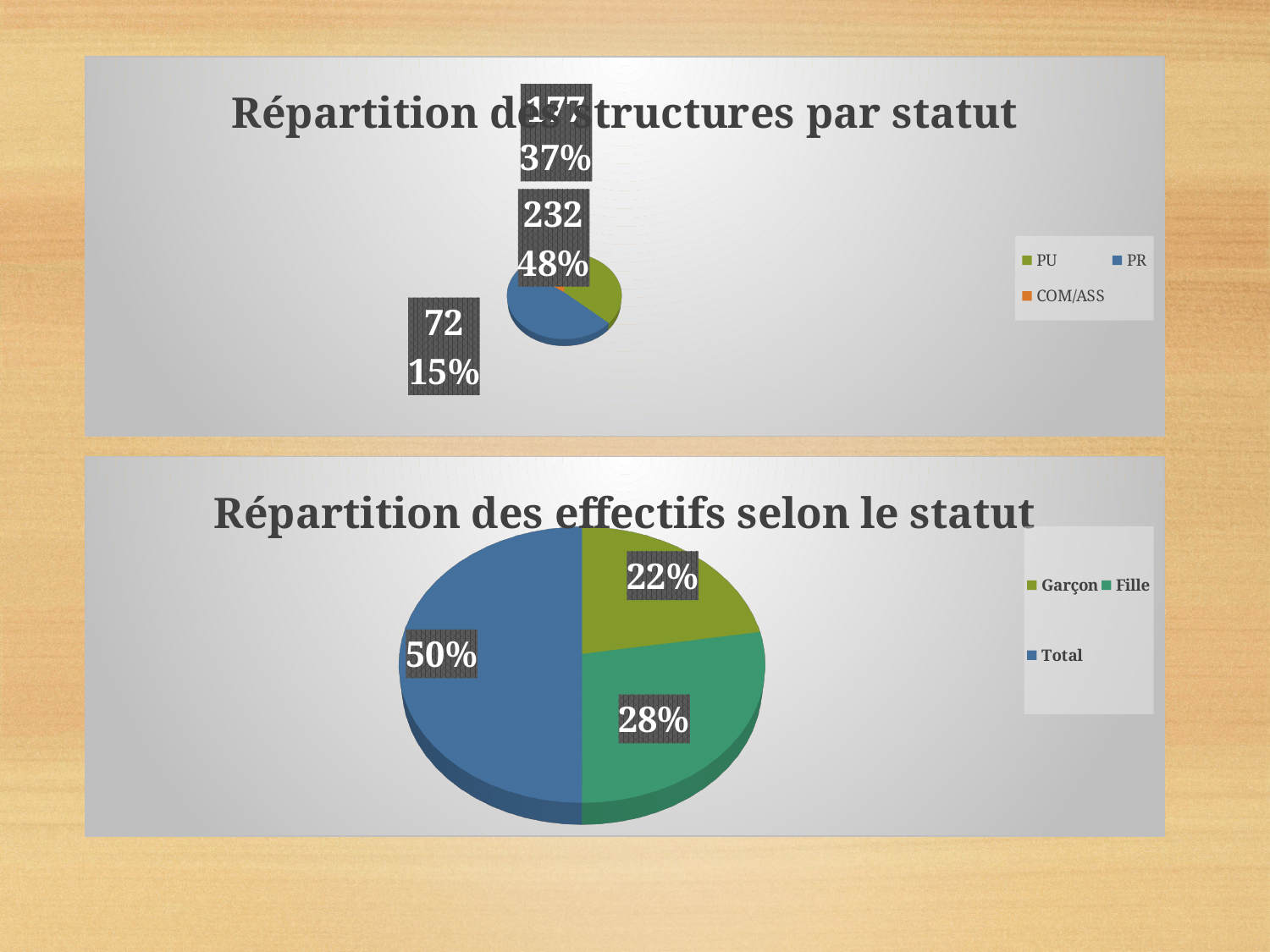
On the top chart, 'Répartition des structures par statut', which category has the largest slice? PR On the chart titled 'Répartition des effectifs selon le statut', which category has the smallest slice? Garçon On the chart titled 'Répartition des effectifs selon le statut', what share of the pie does Total have? 50% On the chart titled 'Répartition des effectifs selon le statut', how many slices does the pie have? 3 On the chart titled 'Répartition des effectifs selon le statut', what is the difference in percentage points between the Fille and Garçon slices? 6% On the chart titled 'Répartition des effectifs selon le statut', what share of the pie does Garçon have? 22% On the chart titled 'Répartition des effectifs selon le statut', which slice is larger, Garçon or Fille? Fille On the top chart, 'Répartition des structures par statut', which category has the smallest slice? COM/ASS What kind of chart is the bottom chart on the slide? Pie chart On the chart titled 'Répartition des effectifs selon le statut', which category has the largest slice? Total How many entries does the legend of the top chart, 'Répartition des structures par statut', list? 3 On the chart titled 'Répartition des effectifs selon le statut', what share of the pie does Fille have? 28%